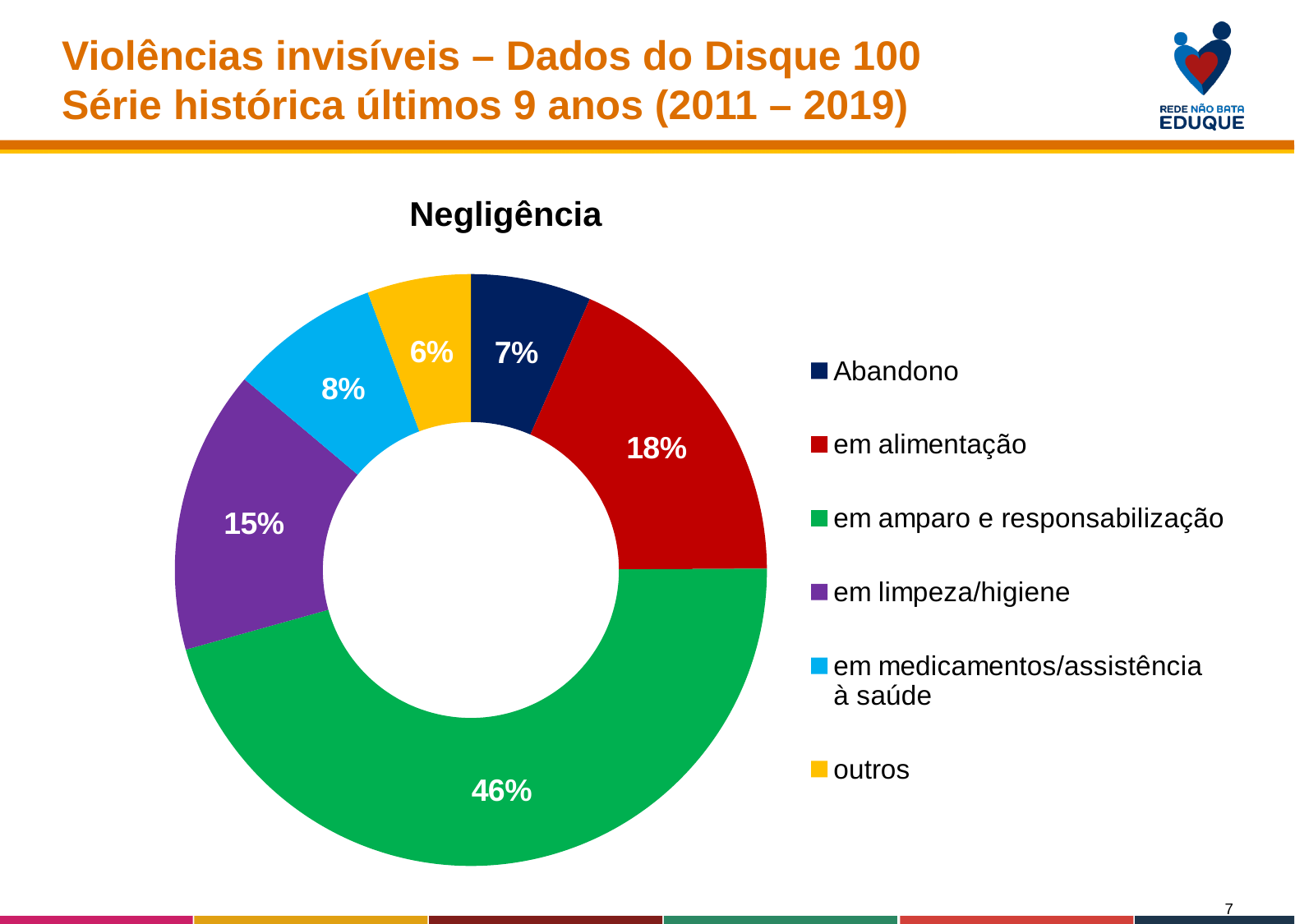
What percentage is shown for 'outros'? 6% What is the difference in percentage points between 'em alimentação' and 'em medicamentos/assistência à saúde'? 10 percentage points Which category has the smallest share of the chart? outros What percentage is shown for 'em alimentação'? 18% How many categories does the legend list? 6 Which is larger, the share for 'em limpeza/higiene' or the share for 'Abandono'? em limpeza/higiene Which category has the largest share of the chart? em amparo e responsabilização What kind of chart is shown on the slide? Doughnut (pie) chart What percentage is shown for 'em limpeza/higiene'? 15% What is the title of the chart? Negligência What percentage is shown for 'em amparo e responsabilização'? 46% What percentage is shown for 'Abandono'? 7%